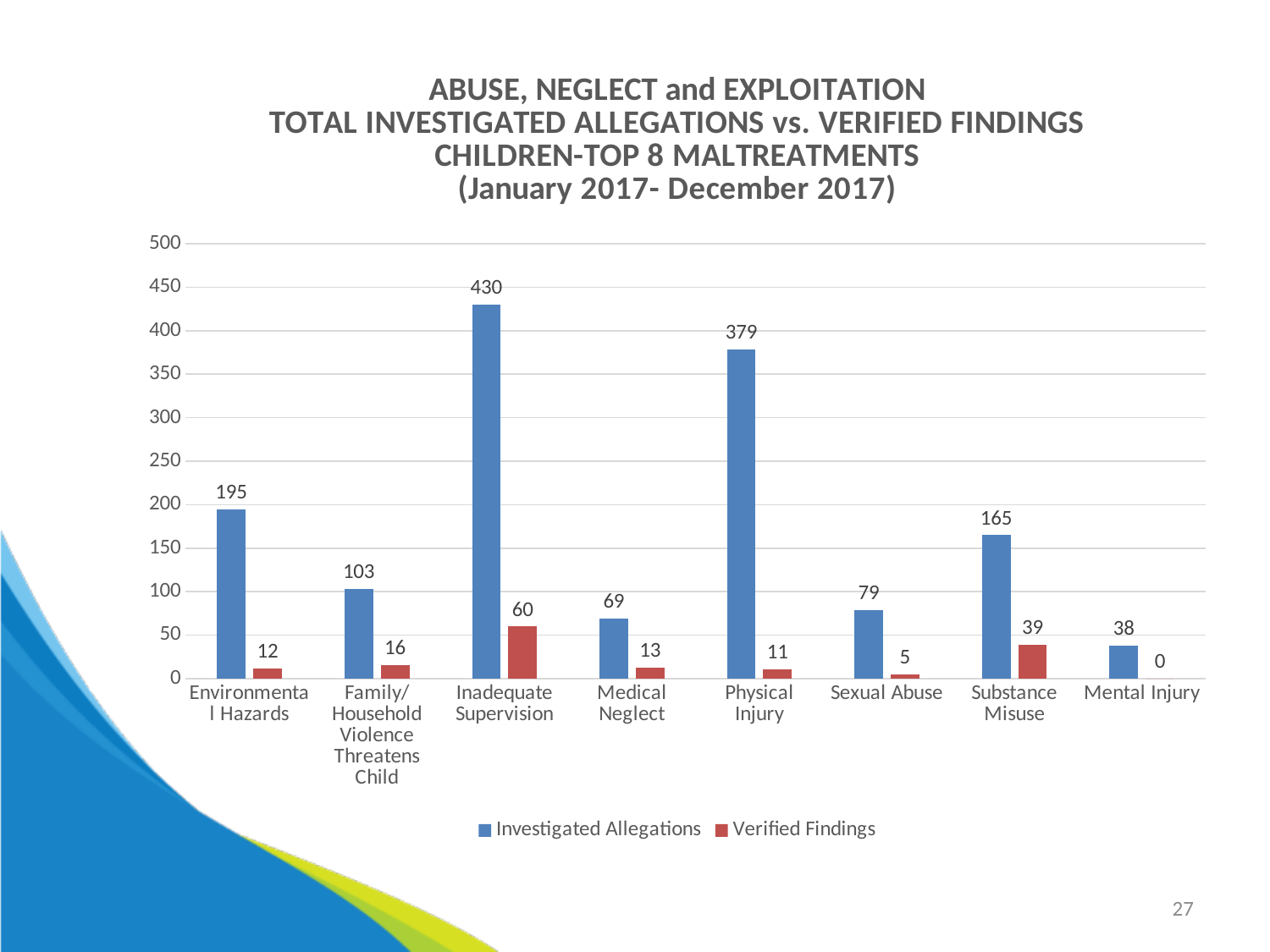
What is the number of Verified Findings for Sexual Abuse? 5 Which colour represents Verified Findings in the chart? Red Which has more Investigated Allegations, Environmental Hazards or Substance Misuse? Environmental Hazards What is the difference between Investigated Allegations and Verified Findings for Physical Injury? 368 What is the number of Investigated Allegations for Inadequate Supervision? 430 What is the difference in Investigated Allegations between Inadequate Supervision and Physical Injury? 51 Which maltreatment category has the lowest number of Verified Findings? Mental Injury What is the number of Verified Findings for Substance Misuse? 39 Which maltreatment category has the highest number of Investigated Allegations? Inadequate Supervision How many maltreatment categories are shown on the x axis? 8 What kind of chart is shown on the slide? Bar chart How many series does the legend list? 2